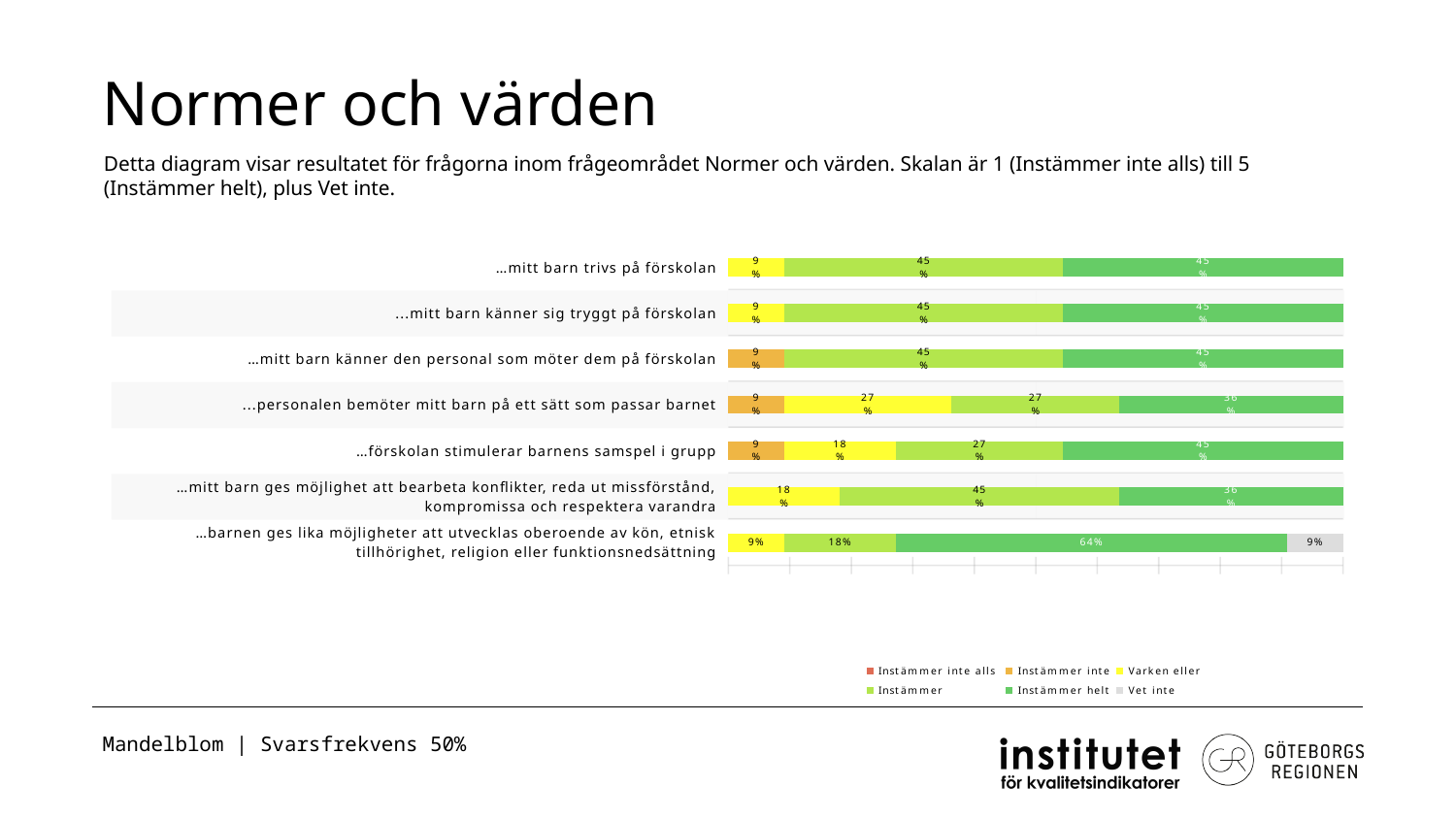
What is the 'Instämmer helt' value for '…barnen ges lika möjligheter att utvecklas oberoende av kön, etnisk tillhörighet, religion eller funktionsnedsättning'? 64% What is the difference between the 'Instämmer helt' value (64%) and the 'Instämmer' value (18%) for '…barnen ges lika möjligheter att utvecklas oberoende av kön, etnisk tillhörighet, religion eller funktionsnedsättning'? 46% How many series does the legend list? 6 What is the 'Instämmer' value for '…mitt barn ges möjlighet att bearbeta konflikter, reda ut missförstånd, kompromissa och respektera varandra'? 45% Which is larger: the 'Instämmer helt' value for '…förskolan stimulerar barnens samspel i grupp' or for '…personalen bemöter mitt barn på ett sätt som passar barnet'? …förskolan stimulerar barnens samspel i grupp What is the title of the slide containing the chart? Normer och värden What is the 'Vet inte' value for '…barnen ges lika möjligheter att utvecklas oberoende av kön, etnisk tillhörighet, religion eller funktionsnedsättning'? 9% How many statements (categories) are plotted in the chart? 7 Which statement has the highest 'Instämmer helt' value? …barnen ges lika möjligheter att utvecklas oberoende av kön, etnisk tillhörighet, religion eller funktionsnedsättning What is the total of the stacked bar for '…förskolan stimulerar barnens samspel i grupp' (9% + 18% + 27% + 45%)? 99% What kind of chart is shown on the slide? Stacked bar chart What is the 'Varken eller' value for '…personalen bemöter mitt barn på ett sätt som passar barnet'? 27%